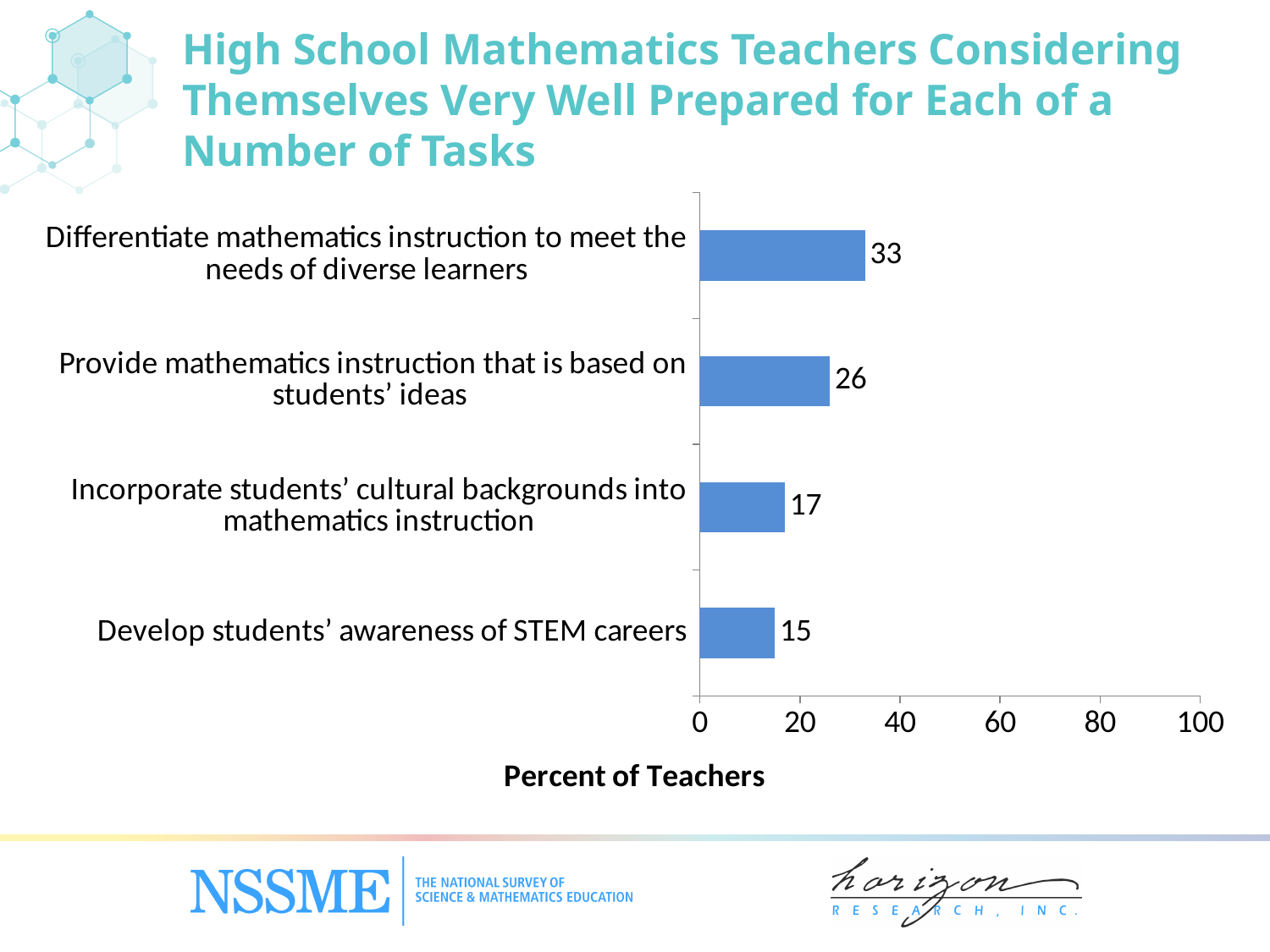
Which is larger: the value for incorporating students' cultural backgrounds or the value for developing students' awareness of STEM careers? Incorporate students' cultural backgrounds into mathematics instruction What is the difference between the values for instruction based on students' ideas and incorporating students' cultural backgrounds? 9 What is the difference between the values for differentiating instruction for diverse learners and developing students' awareness of STEM careers? 18 How many tasks are shown in the chart? 4 Which task has the lowest percent of teachers considering themselves very well prepared? Develop students' awareness of STEM careers Which task has the highest percent of teachers considering themselves very well prepared? Differentiate mathematics instruction to meet the needs of diverse learners What kind of chart is shown on the slide? Bar chart What is the value for 'Provide mathematics instruction that is based on students' ideas'? 26 What percent of teachers consider themselves very well prepared to develop students' awareness of STEM careers? 15 What percent of teachers consider themselves very well prepared to differentiate mathematics instruction to meet the needs of diverse learners? 33 Is the value for differentiating mathematics instruction for diverse learners greater or less than 40? less What is the value for 'Incorporate students' cultural backgrounds into mathematics instruction'? 17